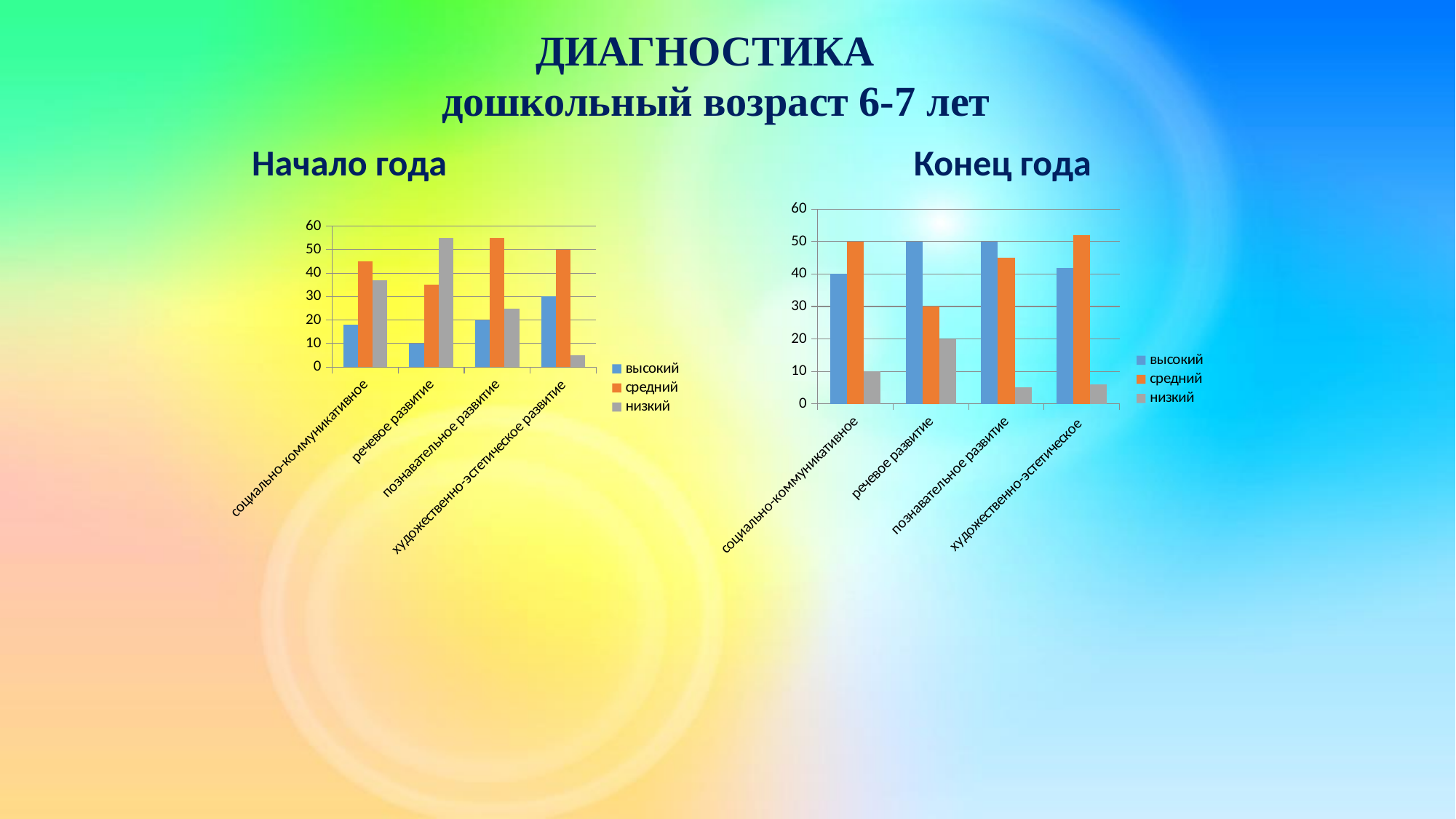
How many categories are shown on the x axis of the 'Начало года' chart? 4 In the 'Конец года' chart, which is larger for 'познавательное развитие': 'высокий' or 'средний'? высокий What kind of chart is the 'Начало года' chart? bar chart In the 'Начало года' chart, which category has the highest 'низкий' value? речевое развитие In the 'Начало года' chart, which category has the lowest 'низкий' value? художественно-эстетическое развитие How many series does the legend of the 'Конец года' chart list? 3 Which colour represents the 'средний' series in both charts? orange In the 'Конец года' chart, what is the value of 'высокий' for 'речевое развитие'? 50 In the 'Конец года' chart, is the value of 'средний' for 'художественно-эстетическое' greater or less than 50? greater In the 'Начало года' chart, what is the value of 'высокий' for 'речевое развитие'? 10 In the 'Начало года' chart, what is the value of 'средний' for 'художественно-эстетическое развитие'? 50 In the 'Конец года' chart, what is the value of 'средний' for 'речевое развитие'? 30